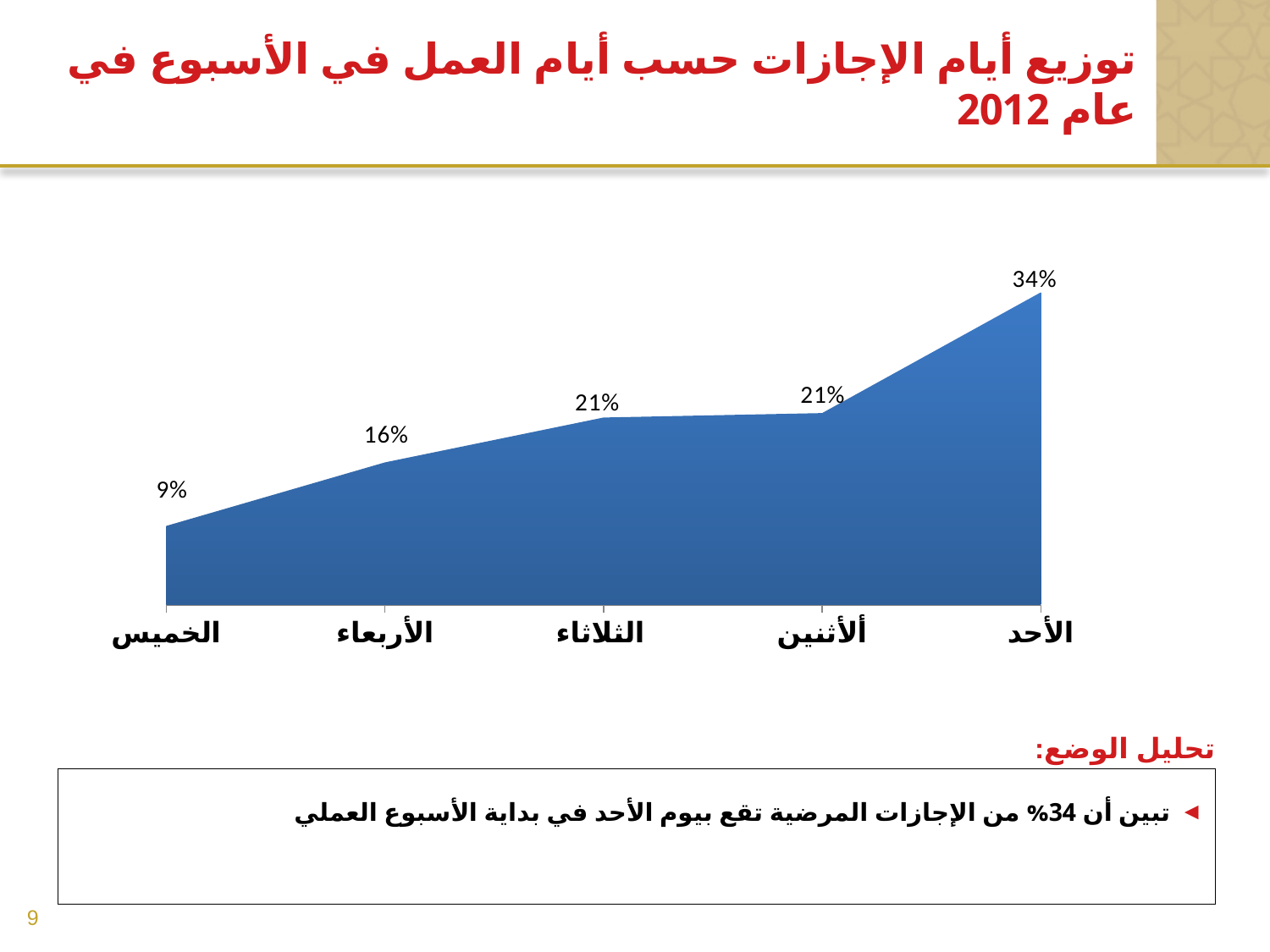
Which day has the highest share of leave days? الأحد What percentage of leave days falls on الأحد (Sunday)? 34% Do the values rise or fall moving from الخميس (Thursday) on the left to الأحد (Sunday) on the right? Rise What value is shown for الثلاثاء (Tuesday)? 21% Which day has the lowest share of leave days? الخميس What is the difference between the values for الأربعاء (Wednesday) and الخميس (Thursday)? 7% Which is larger, the value for الأحد (Sunday) or the value for ألأثنين (Monday)? الأحد What value is shown for الأربعاء (Wednesday)? 16% How many days are shown on the x axis of the chart? 5 What kind of chart is shown on the slide? Area chart What is the difference between the values for الأحد (Sunday) and الخميس (Thursday)? 25% What percentage of leave days falls on الخميس (Thursday)? 9%